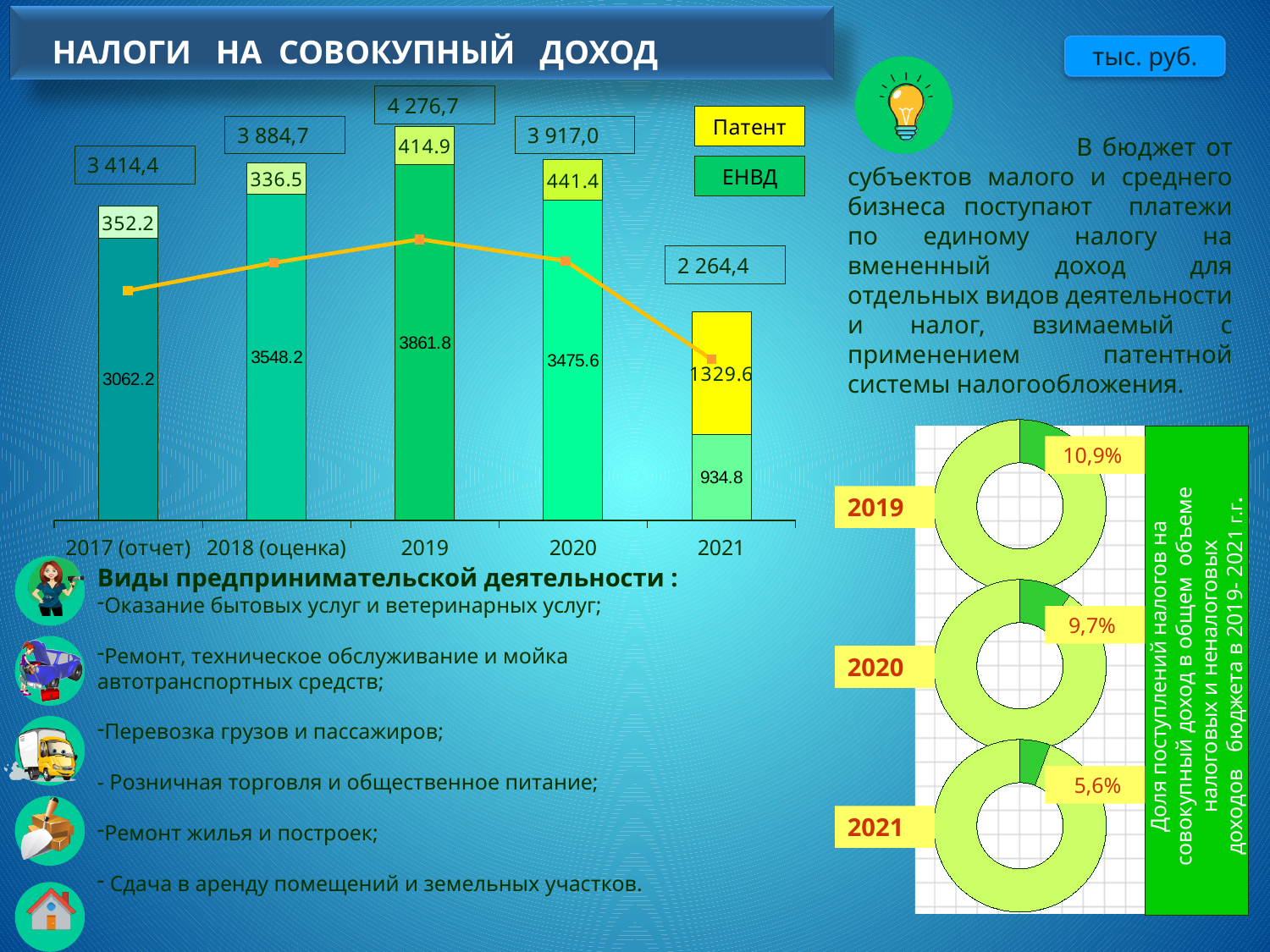
In the bar chart 'НАЛОГИ НА СОВОКУПНЫЙ ДОХОД', what is the difference between the ЕНВД values for 2019 and 2020? 386.2 In the bar chart 'НАЛОГИ НА СОВОКУПНЫЙ ДОХОД', which year has the lowest ЕНВД value? 2021 In the donut charts on the right of the slide, do the shares rise or fall from 2019 to 2021? fall In the bar chart 'НАЛОГИ НА СОВОКУПНЫЙ ДОХОД', which is larger: the Патент value for 2020 or for 2019? 2020 In the bar chart 'НАЛОГИ НА СОВОКУПНЫЙ ДОХОД', which year has the highest total? 2019 In the bar chart 'НАЛОГИ НА СОВОКУПНЫЙ ДОХОД', how many series does the legend list? 2 In the bar chart 'НАЛОГИ НА СОВОКУПНЫЙ ДОХОД', what is the Патент value for 2021? 1329.6 In the bar chart 'НАЛОГИ НА СОВОКУПНЫЙ ДОХОД', what is the ЕНВД value for 2019? 3861.8 In the donut charts on the right of the slide, what share is shown for 2020? 9,7% In the bar chart 'НАЛОГИ НА СОВОКУПНЫЙ ДОХОД', how many years are shown on the x axis? 5 In the bar chart 'НАЛОГИ НА СОВОКУПНЫЙ ДОХОД', what is the total shown above the bar for 2018 (оценка)? 3 884,7 In the bar chart 'НАЛОГИ НА СОВОКУПНЫЙ ДОХОД', what is the sum of the ЕНВД and Патент values for 2017 (отчет)? 3 414,4